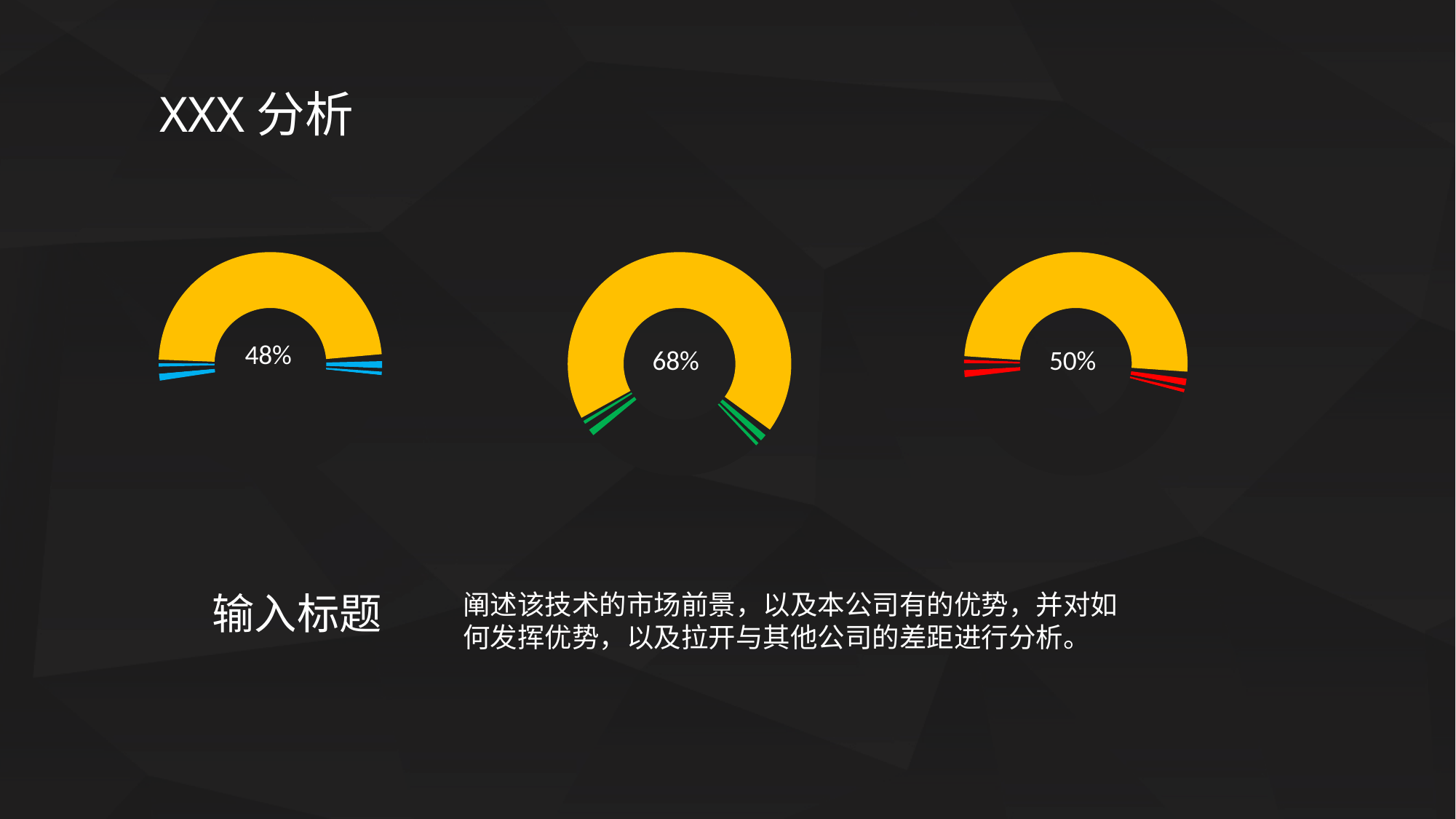
Which is larger, the percentage in the middle chart or the percentage in the right chart? The middle chart (68%) What is the difference between the percentage in the middle chart and the percentage in the left chart? 20% What percentage is shown in the centre of the right chart? 50% Which of the three charts shows the highest percentage? The middle chart (68%) What colour are the small accent segments on the right chart? Red How many gauge charts are shown on the slide? 3 What percentage is shown in the centre of the middle chart? 68% What colour are the small accent segments on the left chart? Blue What is the difference between the percentage in the right chart and the percentage in the left chart? 2% What percentage is shown in the centre of the left chart? 48% What kind of chart is used on this slide? Doughnut (gauge) chart Which of the three charts shows the lowest percentage? The left chart (48%)